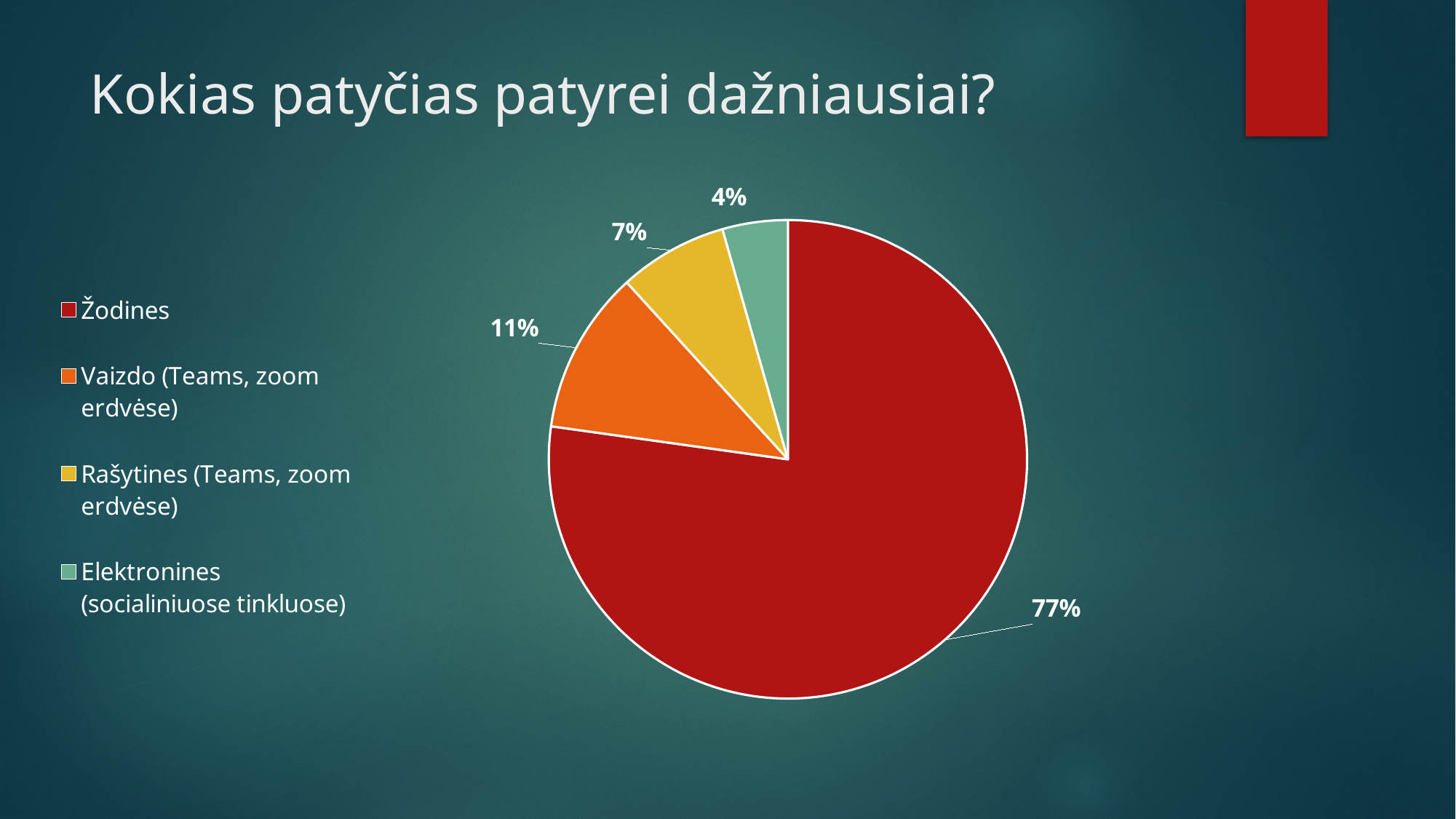
Which category has the smallest slice of the pie? Elektronines (socialiniuose tinkluose) Which is larger, the share of Rašytines (Teams, zoom erdvėse) or Elektronines (socialiniuose tinkluose)? Rašytines (Teams, zoom erdvėse) What colour is the slice for Vaizdo (Teams, zoom erdvėse)? orange What is the difference between the shares of Žodines and Vaizdo (Teams, zoom erdvėse)? 66% What share of the pie does Vaizdo (Teams, zoom erdvėse) have? 11% What share of the pie does Žodines have? 77% What share of the pie does Elektronines (socialiniuose tinkluose) have? 4% What kind of chart is shown on the slide? pie chart How many categories does the pie chart show? 4 What is the title of the slide containing the pie chart? Kokias patyčias patyrei dažniausiai? Which category has the largest slice of the pie? Žodines